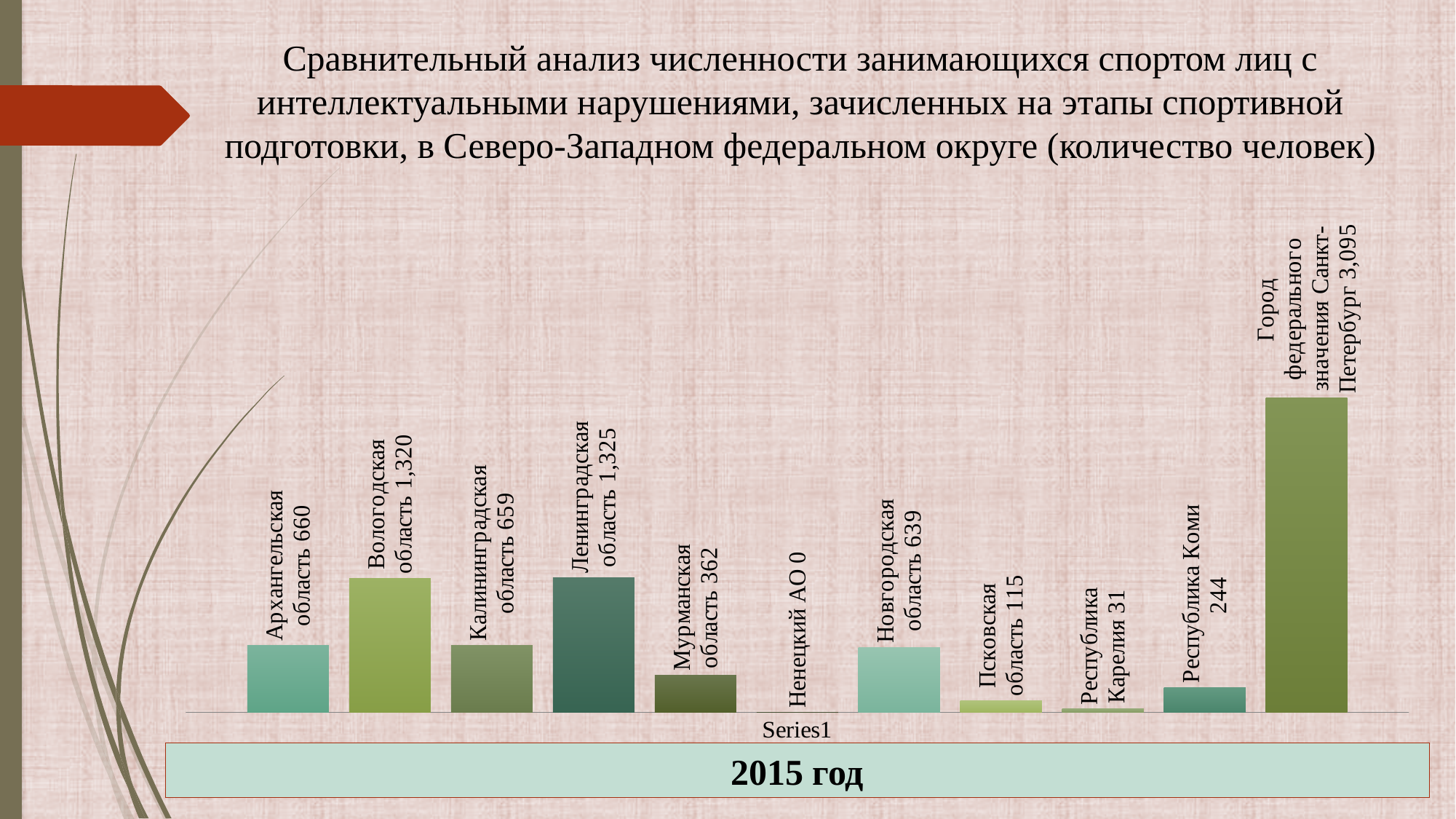
What is the difference between the values for Псковская область and Республика Карелия? 84 How many categories are plotted in the chart? 11 Which category has the highest value? Город федерального значения Санкт-Петербург What is the value for Ненецкий АО? 0 Which is larger, the value for Ленинградская область or the value for Калининградская область? Ленинградская область What year is shown in the label below the chart? 2015 год What is the value for Мурманская область? 362 What is the value for Архангельская область? 660 Which category has the lowest value? Ненецкий АО What is the difference between the values for Вологодская область and Новгородская область? 681 What kind of chart is shown on the slide? Bar chart What is the value for Республика Коми? 244